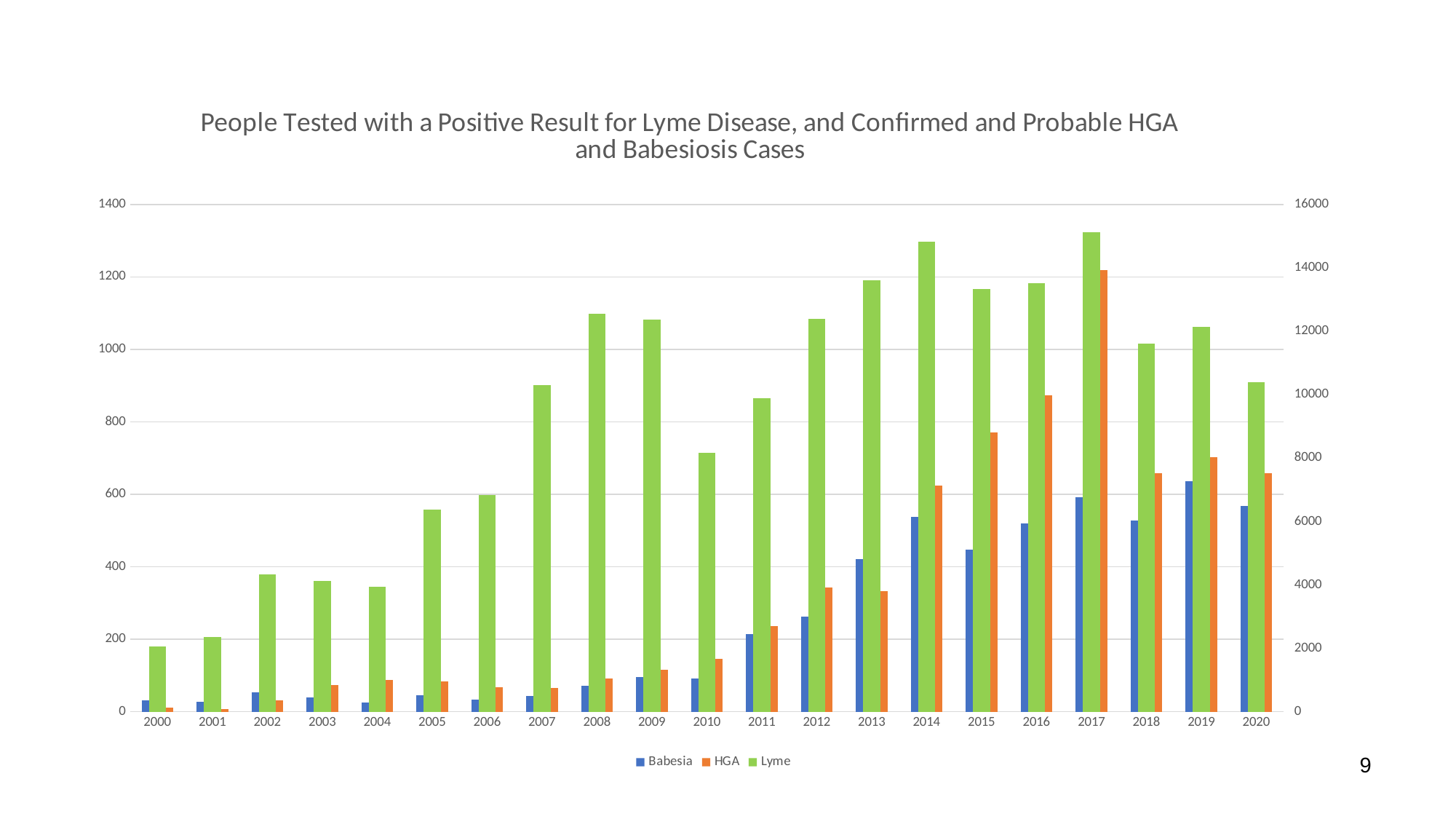
How many years are shown along the x axis? 21 Is the Babesia bar taller in 2014 or in 2015? 2014 Is the HGA bar taller in 2015 or in 2016? 2016 Measured against the left-hand axis, is the Babesia bar for 2011 greater or less than 200? greater What kind of chart is shown on the slide? bar chart In which year is the Lyme bar the shortest? 2000 In which year is the Babesia bar the tallest? 2019 Is the Lyme bar taller in 2012 or in 2013? 2013 How many series does the legend list? 3 Which series is shown in green? Lyme In which year is the HGA bar the tallest? 2017 Overall, do the Babesia bars rise or fall from 2000 to 2019? rise